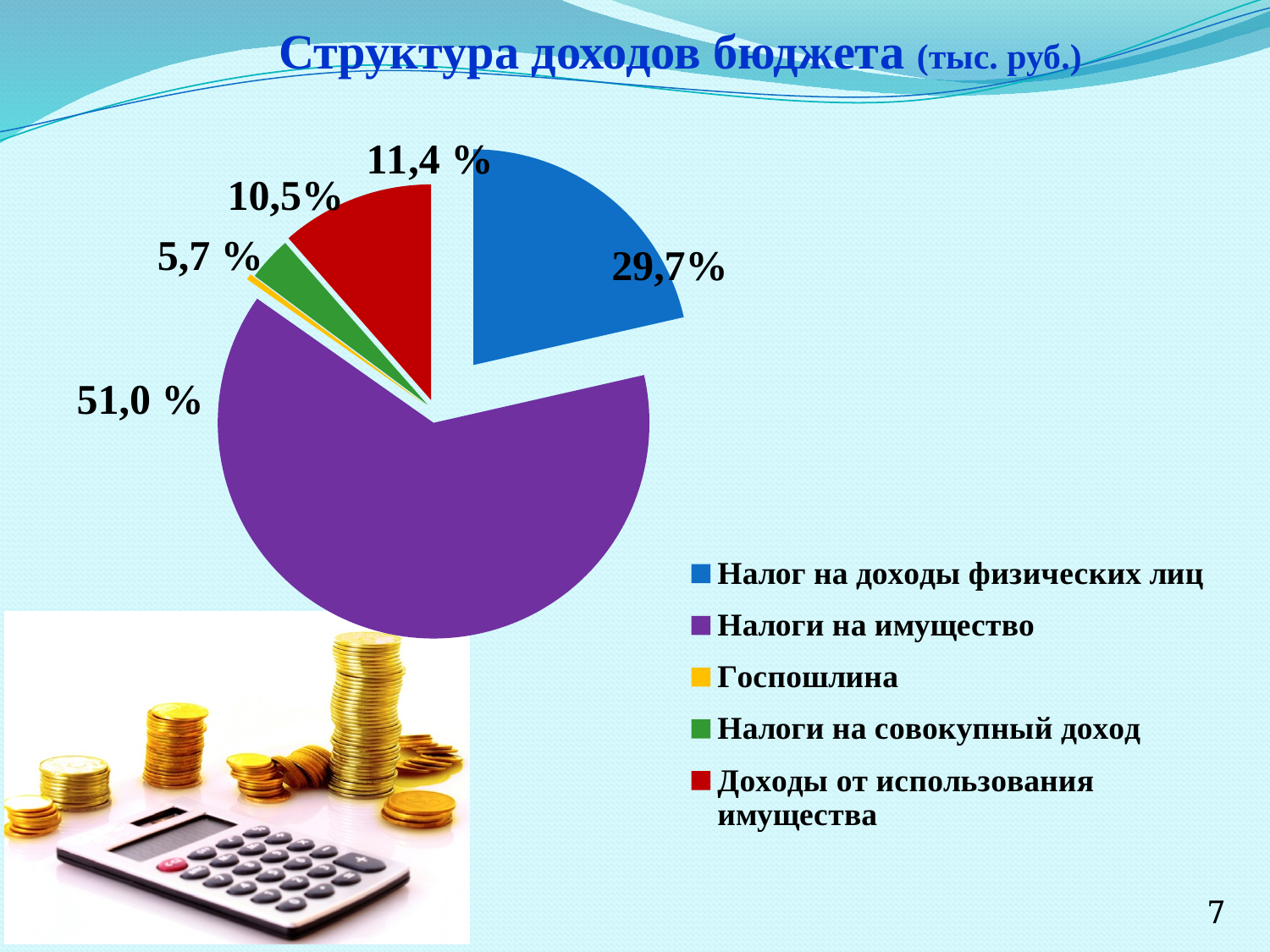
What kind of chart is shown on the slide? pie chart What share of the pie is labelled for Налоги на имущество? 51,0 % Which category has the largest slice of the pie? Налоги на имущество Which colour represents Госпошлина in the legend? yellow What is the title of the chart? Структура доходов бюджета (тыс. руб.) How many slices does the pie chart have? 5 By how many percentage points does the share of Налоги на имущество exceed the share of Налог на доходы физических лиц? 21,3 What share of the pie is labelled for Налог на доходы физических лиц? 29,7% Which is larger: the slice for Налог на доходы физических лиц or the slice for Налоги на имущество? Налоги на имущество Which category has the smallest slice of the pie? Госпошлина What share of the pie is labelled for Налоги на совокупный доход? 5,7 % How many entries does the legend list? 5